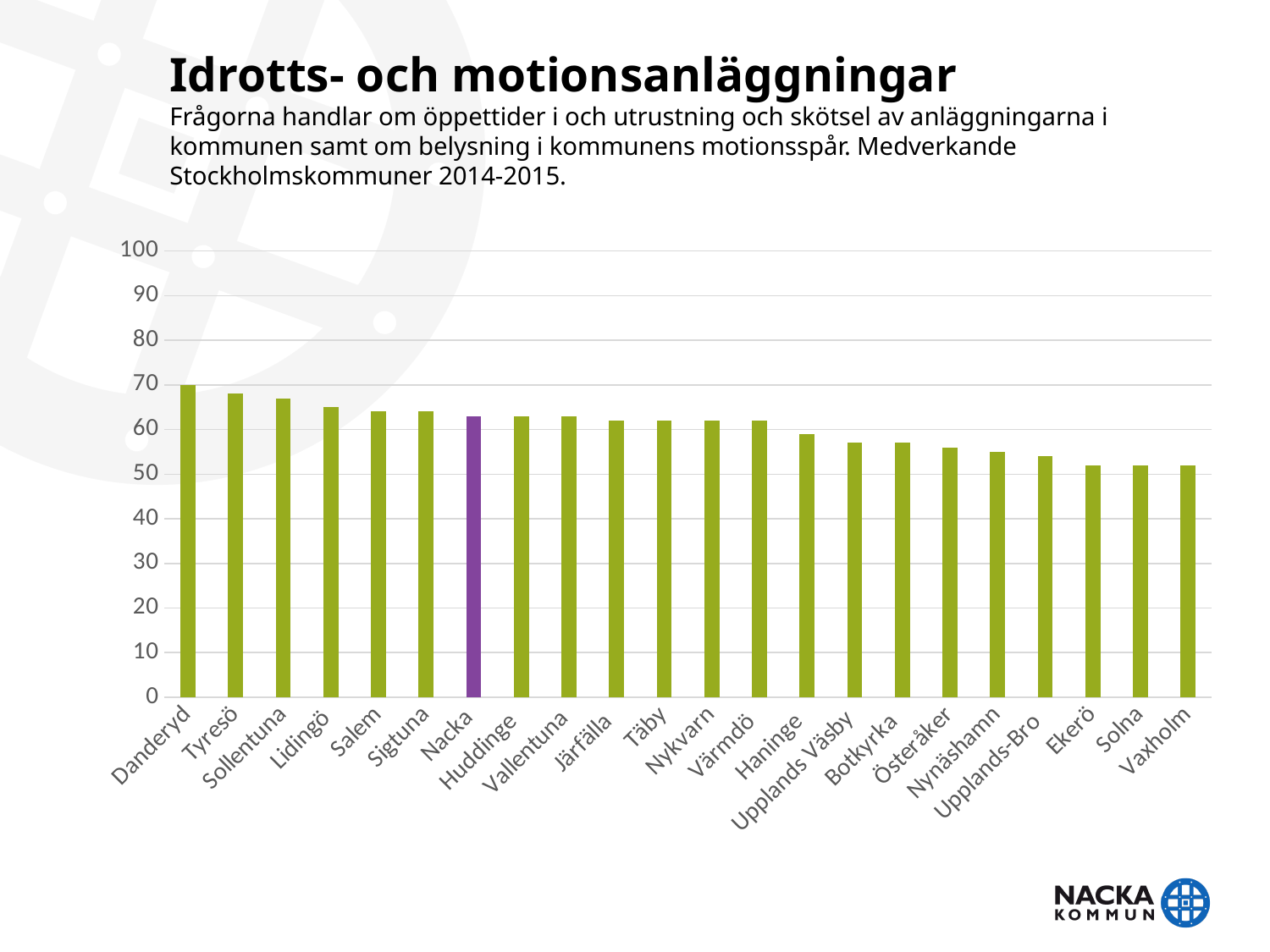
Which municipality has the highest value in the chart? Danderyd Which has a larger value, Tyresö or Haninge? Tyresö Is the value for Vaxholm greater or less than 50? greater Is the value for Botkyrka greater or less than 60? less What kind of chart is shown on the slide? bar chart Which municipality's bar is shown in purple instead of green? Nacka Do the values rise or fall from left to right along the x axis? fall Is the value for Nacka greater or less than 60? greater How many municipalities are shown on the x axis of the chart? 22 Which has a larger value, Nacka or Ekerö? Nacka